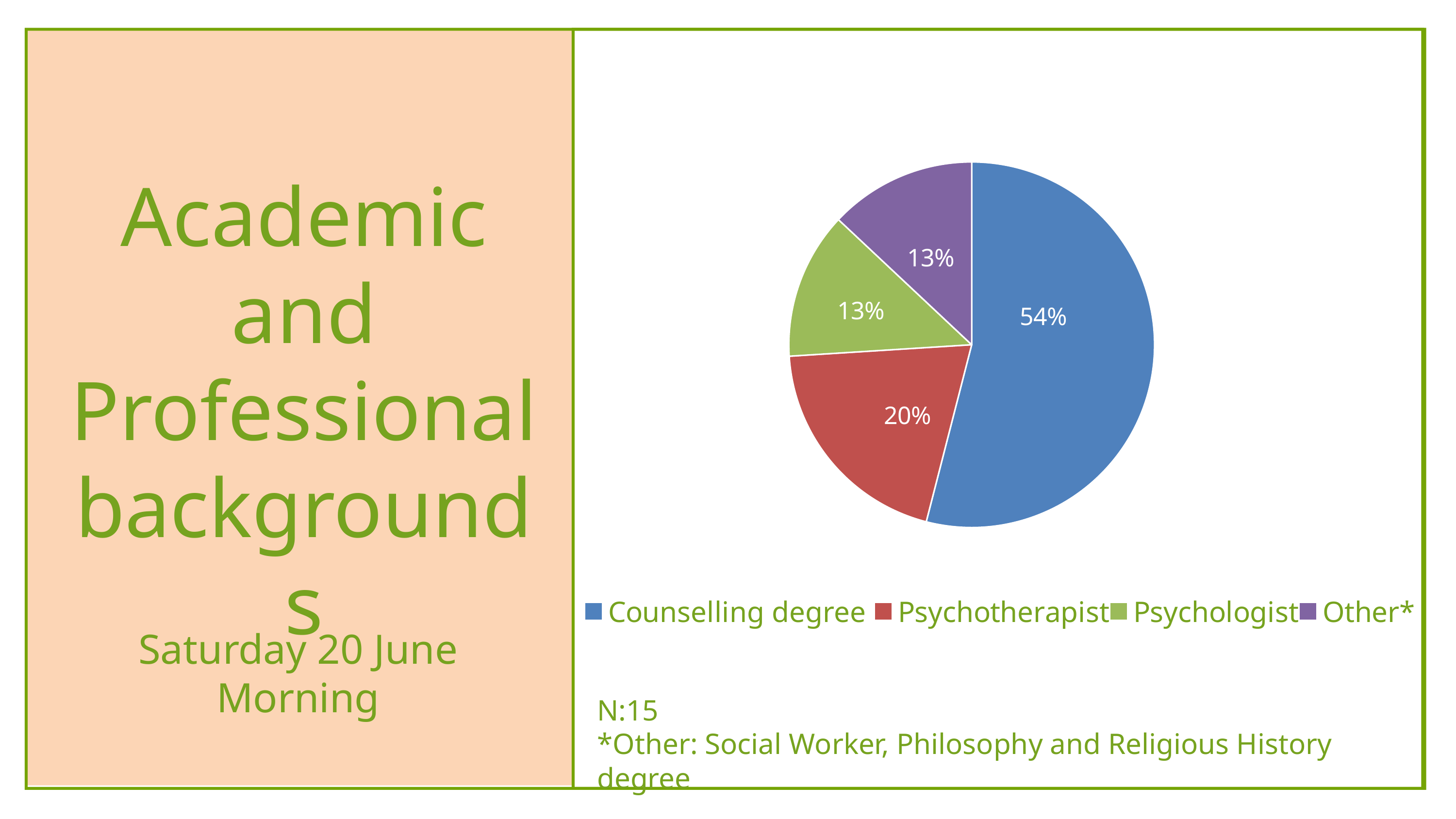
What is the difference between the Counselling degree share and the Psychotherapist share? 34% What share of the pie does Other* have? 13% What sample size (N) is stated below the chart? N:15 Which category has the largest slice of the pie? Counselling degree What share of the pie does Psychologist have? 13% How many slices does the pie chart have? 4 Which is larger, the Psychotherapist slice or the Psychologist slice? Psychotherapist What kind of chart is shown on the slide? pie chart How many entries does the legend list? 4 What colour is the Counselling degree slice? blue What share of the pie does Counselling degree have? 54%